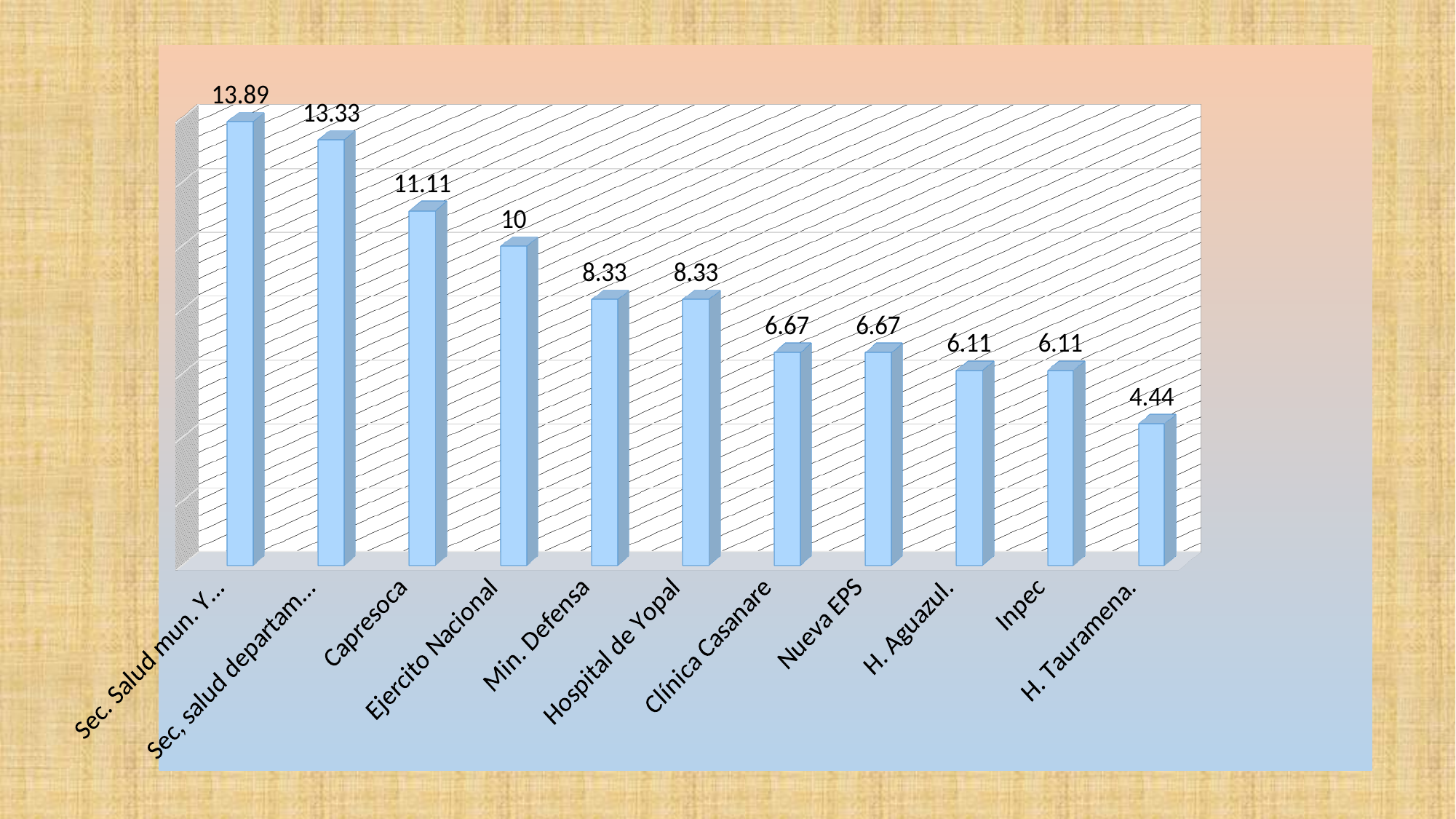
Which is larger, the value for Hospital de Yopal or the value for Clínica Casanare? Hospital de Yopal What is the value for H. Tauramena.? 4.44 What is the difference between the values for Capresoca and Min. Defensa? 2.78 What is the difference between the values for Ejercito Nacional and H. Tauramena.? 5.56 What kind of chart is shown on the slide? Bar chart How many categories are shown in the chart? 11 What is the value for Ejercito Nacional? 10 Do the values rise or fall from left to right along the x axis? Fall What is the value for Inpec? 6.11 What is the value for Nueva EPS? 6.67 Which category has the lowest value? H. Tauramena. What is the value for Capresoca? 11.11